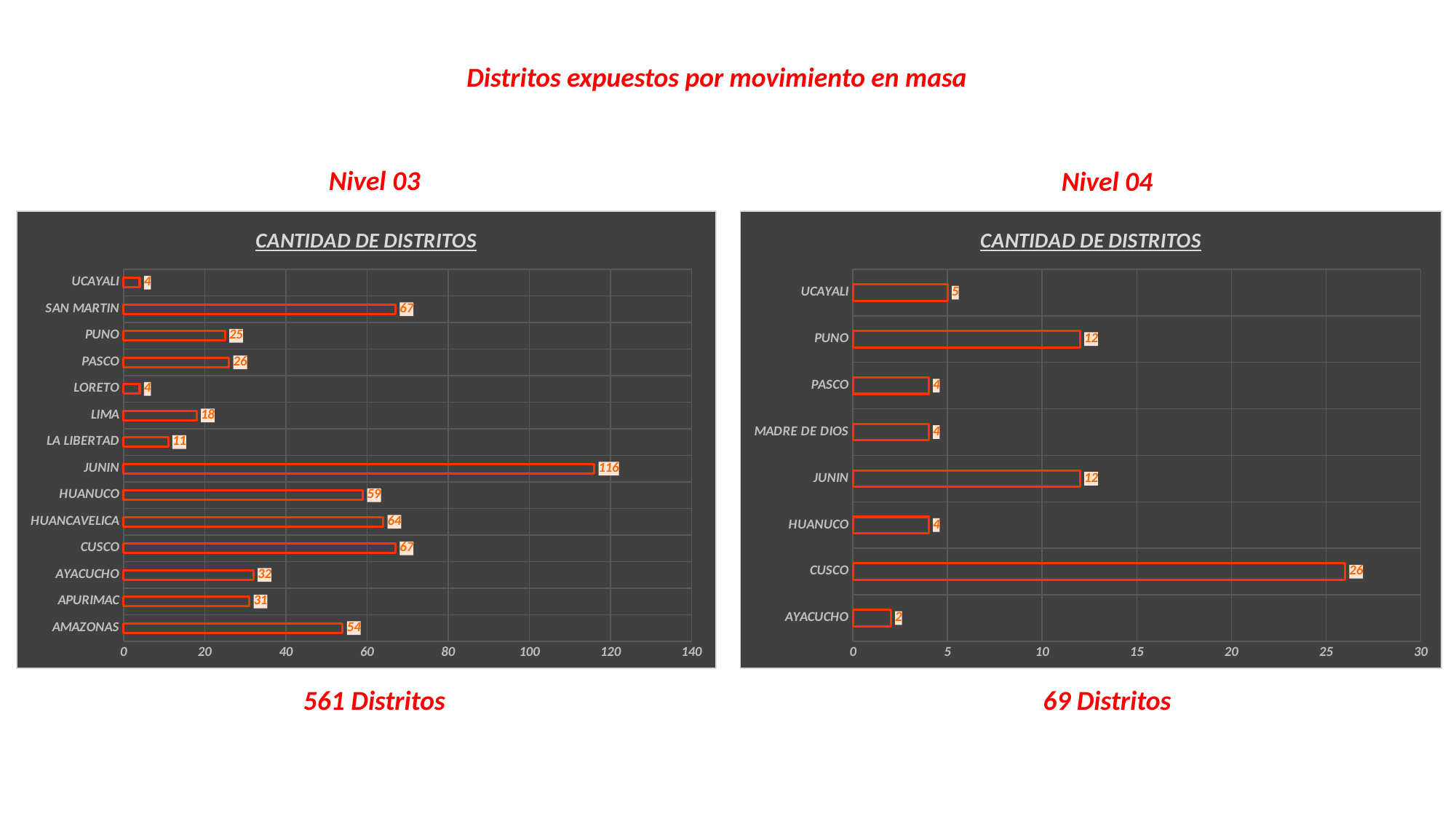
In the Nivel 04 chart, which category has the highest value? CUSCO In the Nivel 03 chart, which is larger, the value for AMAZONAS or the value for AYACUCHO? AMAZONAS In the Nivel 03 chart, what is the value for HUANCAVELICA? 64 What type of chart is the Nivel 04 chart? Bar chart In the Nivel 04 chart, what is the value for PUNO? 12 In the Nivel 04 chart, what is the difference between the values for CUSCO and UCAYALI? 21 In the Nivel 03 chart, what is the difference between the values for JUNIN and HUANUCO? 57 How many categories are shown in the Nivel 04 chart? 8 In the Nivel 03 chart, what is the value for JUNIN? 116 How many categories are shown in the Nivel 03 chart? 14 In the Nivel 03 chart, which category has the highest value? JUNIN In the Nivel 04 chart, which category has the lowest value? AYACUCHO